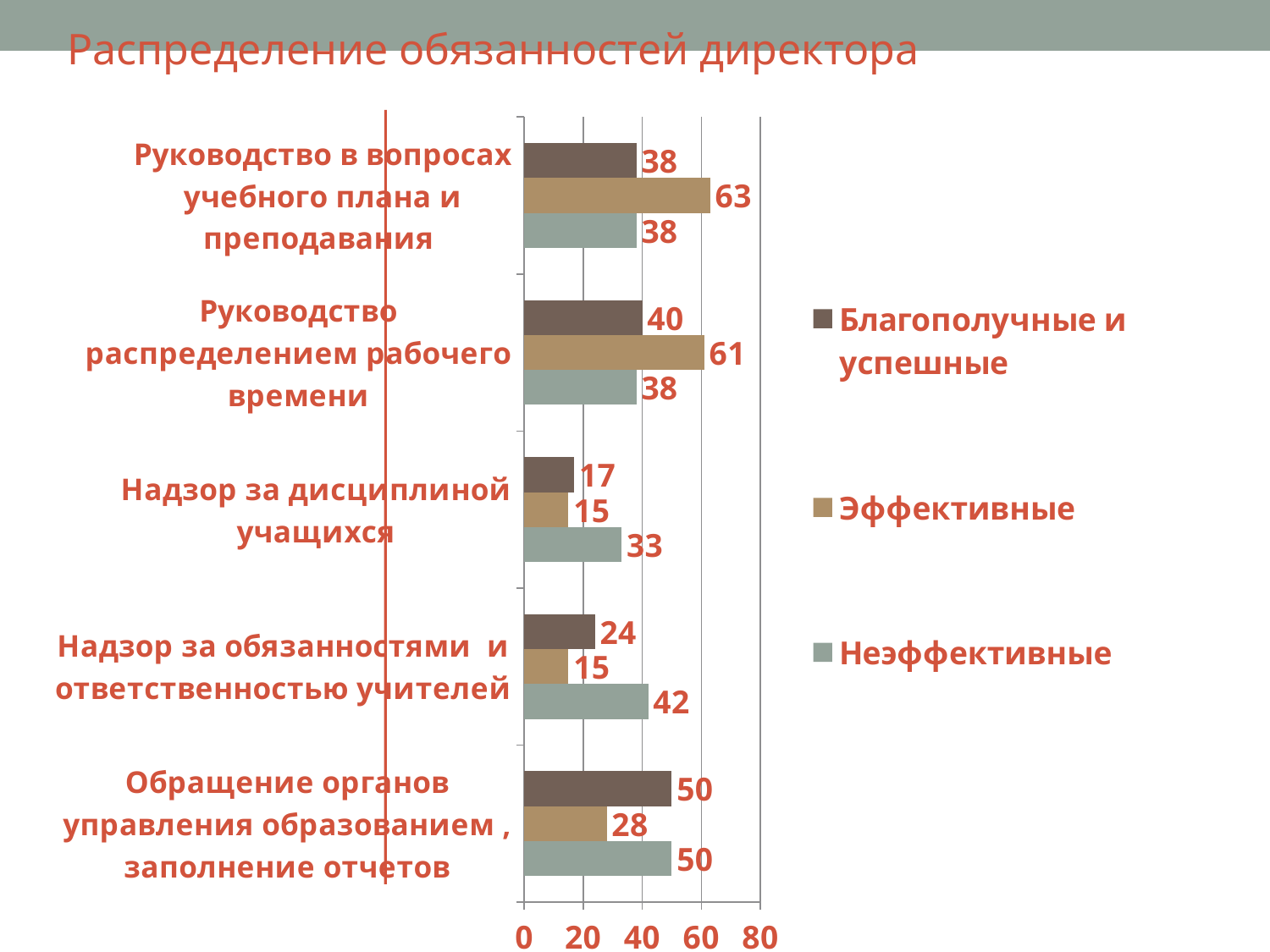
What is the value for "Благополучные и успешные" in the category "Обращение органов управления образованием, заполнение отчетов"? 50 Is the value for "Эффективные" in the category "Обращение органов управления образованием, заполнение отчетов" greater or less than 40? less In the category "Надзор за дисциплиной учащихся", which series has the larger value: "Благополучные и успешные" or "Неэффективные"? Неэффективные What is the value for "Неэффективные" in the category "Надзор за обязанностями и ответственностью учителей"? 42 What is the value for "Эффективные" in the category "Руководство в вопросах учебного плана и преподавания"? 63 How many series does the legend list? 3 How many categories are shown on the chart? 5 What kind of chart is shown on the slide? bar chart Which category has the highest value for the "Эффективные" series? Руководство в вопросах учебного плана и преподавания What is the title of the slide? Распределение обязанностей директора Which category has the lowest value for the "Благополучные и успешные" series? Надзор за дисциплиной учащихся What is the difference between the "Эффективные" and "Неэффективные" values in the category "Руководство распределением рабочего времени"? 23